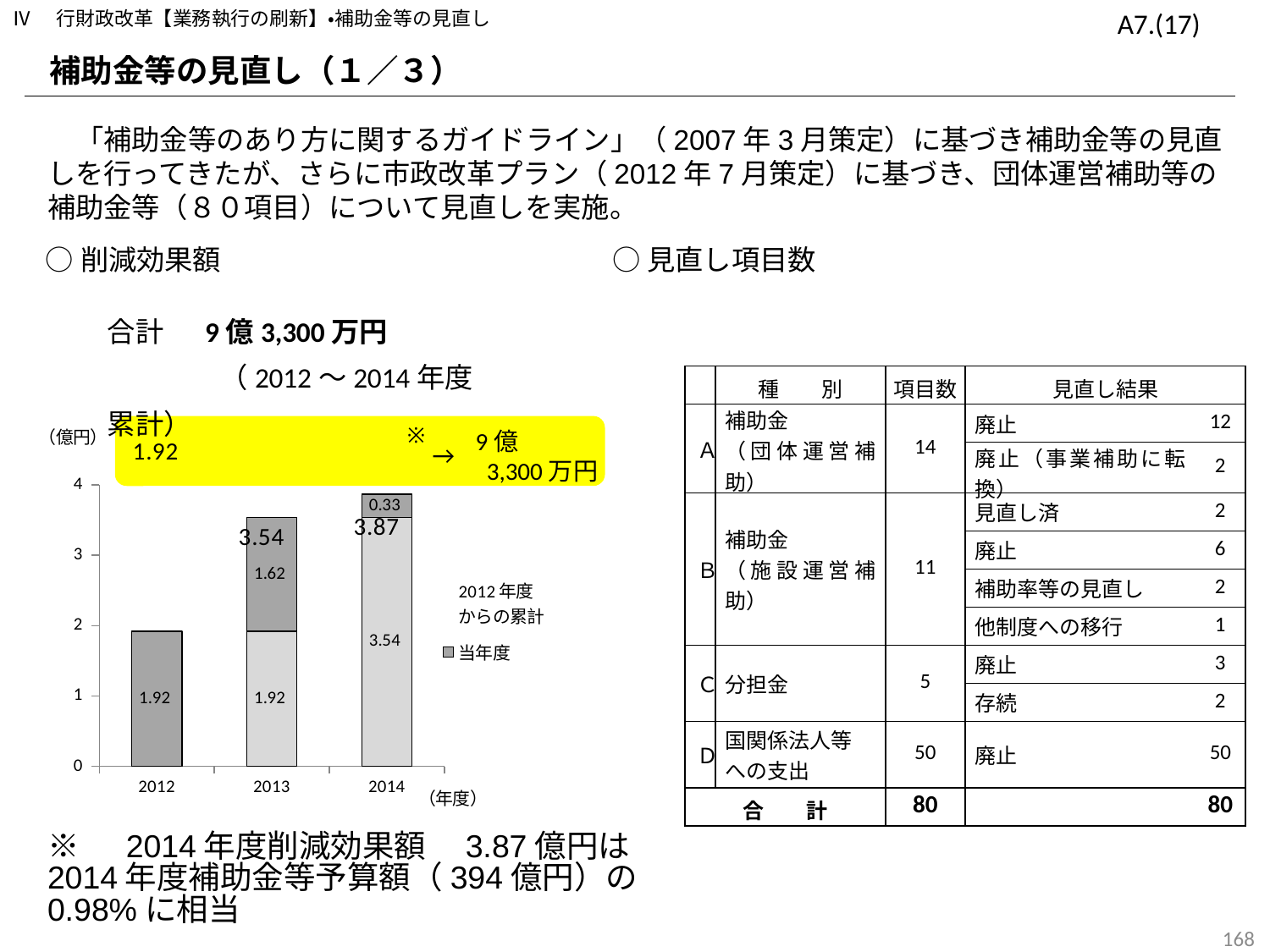
Do the total bar heights rise or fall from 2012 to 2014 in the bar chart? Rise What kind of chart is shown on the left of the slide? Bar chart In the bar chart, which year has the highest total bar? 2014 In the bar chart, which year has the lowest total bar? 2012 In the bar chart, what is the 当年度 value for 2012? 1.92 In the bar chart, what is the 当年度 value for 2014? 0.33 In the bar chart, what is the total of the stacked bar for 2014? 3.87 In the bar chart, what is the 2012年度からの累計 value for 2014? 3.87 In the bar chart, what is the 当年度 value for 2013? 1.62 How many years are shown on the x axis of the bar chart? 3 In the bar chart, what is the total of the stacked bar for 2013? 3.54 In the bar chart, what is the difference between the 2014 total (3.87) and the 2013 total (3.54)? 0.33